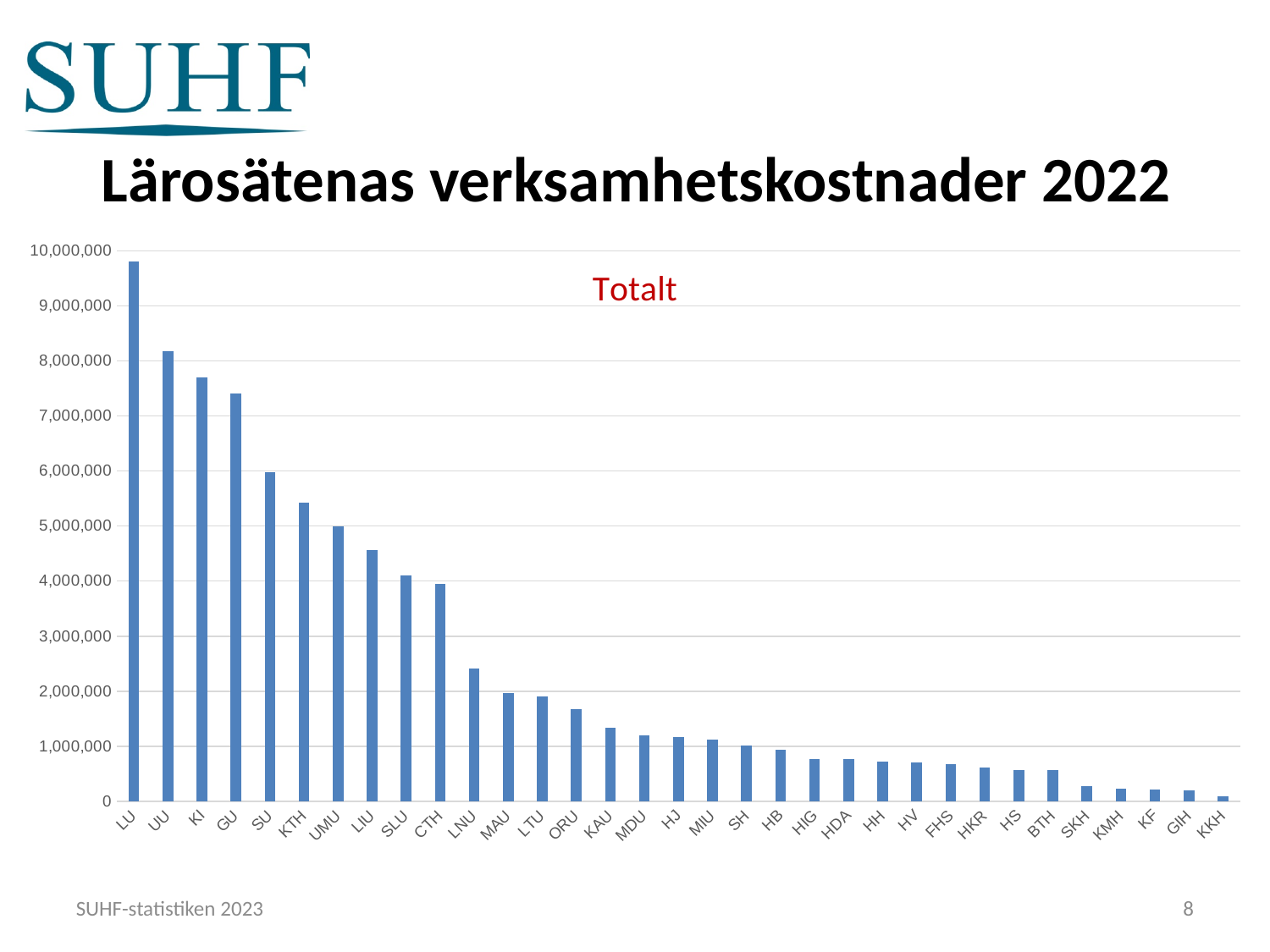
What kind of chart is shown on the slide? bar chart Is the value for LNU greater or less than 2,000,000? greater Which category has the lowest value? KKH Which is larger, the value for KTH or the value for UMU? KTH Which category has the highest value? LU Is the value for HB greater or less than 1,000,000? less Is the value for LU greater or less than 9,000,000? greater Do the values rise or fall moving from left to right along the x axis? fall How many categories are plotted on the x axis? 33 What is the title of the slide? Lärosätenas verksamhetskostnader 2022 Which is larger, the value for KI or the value for GU? KI